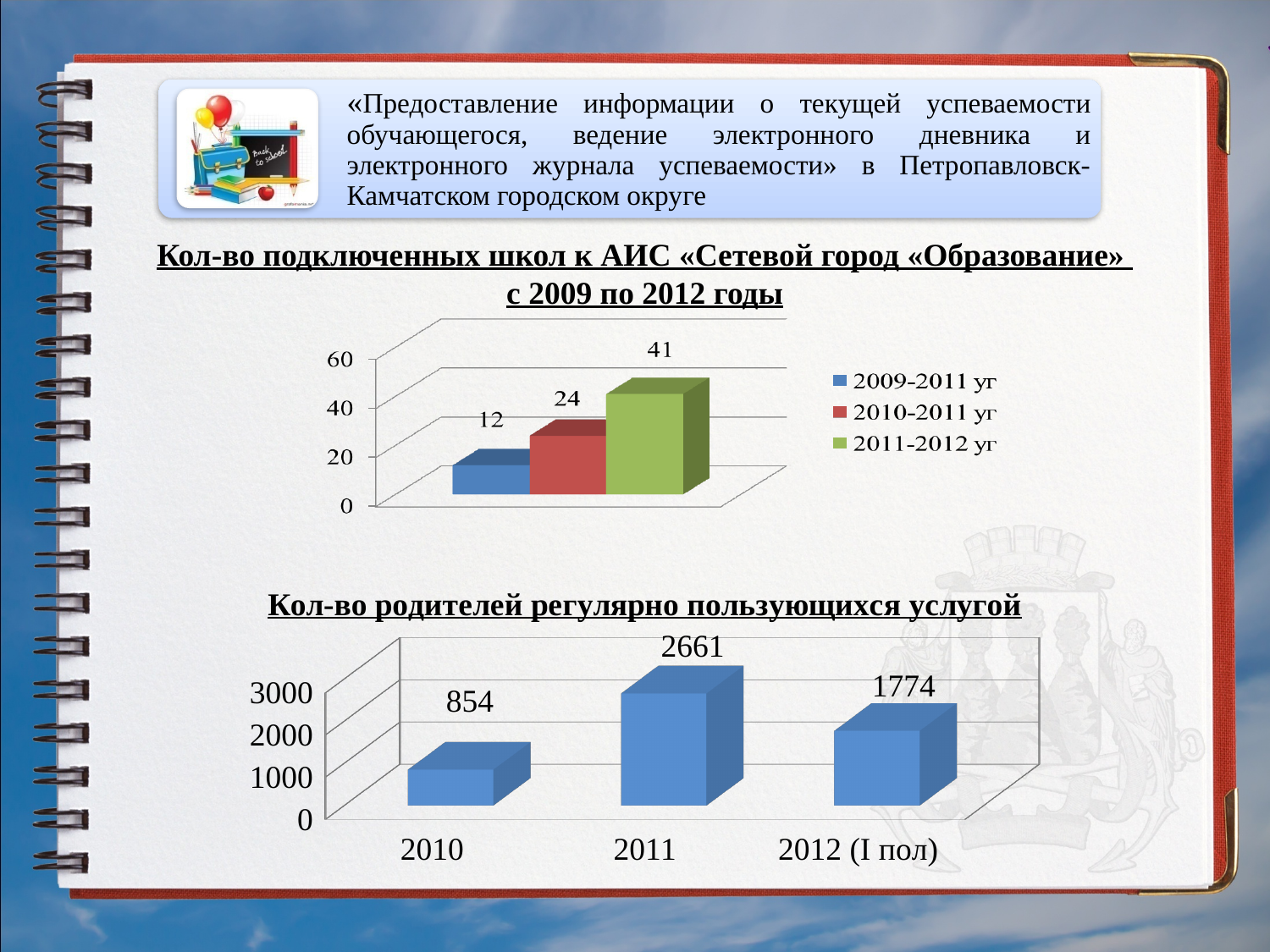
In the top chart, what colour is the bar for 2010-2011 уг? Red In the top chart (number of schools connected to AIS), what is the value for 2009-2011 уг? 12 How many series does the legend of the top chart list? 3 In the bottom chart (number of parents regularly using the service), what is the value for 2012 (I пол)? 1774 In the bottom chart (number of parents regularly using the service), what is the value for 2011? 2661 In the bottom chart, is the value for 2011 greater or less than 2000? greater In the top chart (number of schools connected to AIS), what is the value for 2011-2012 уг? 41 In the bottom chart (number of parents regularly using the service), which category has the lowest value? 2010 In the bottom chart (number of parents regularly using the service), what is the difference between the values for 2011 and 2010? 1807 In the top chart (number of schools connected to AIS), which legend entry has the highest value? 2011-2012 уг What kind of chart is the bottom chart (number of parents regularly using the service)? Bar chart In the top chart (number of schools connected to AIS), what is the difference between the values for 2011-2012 уг and 2010-2011 уг? 17